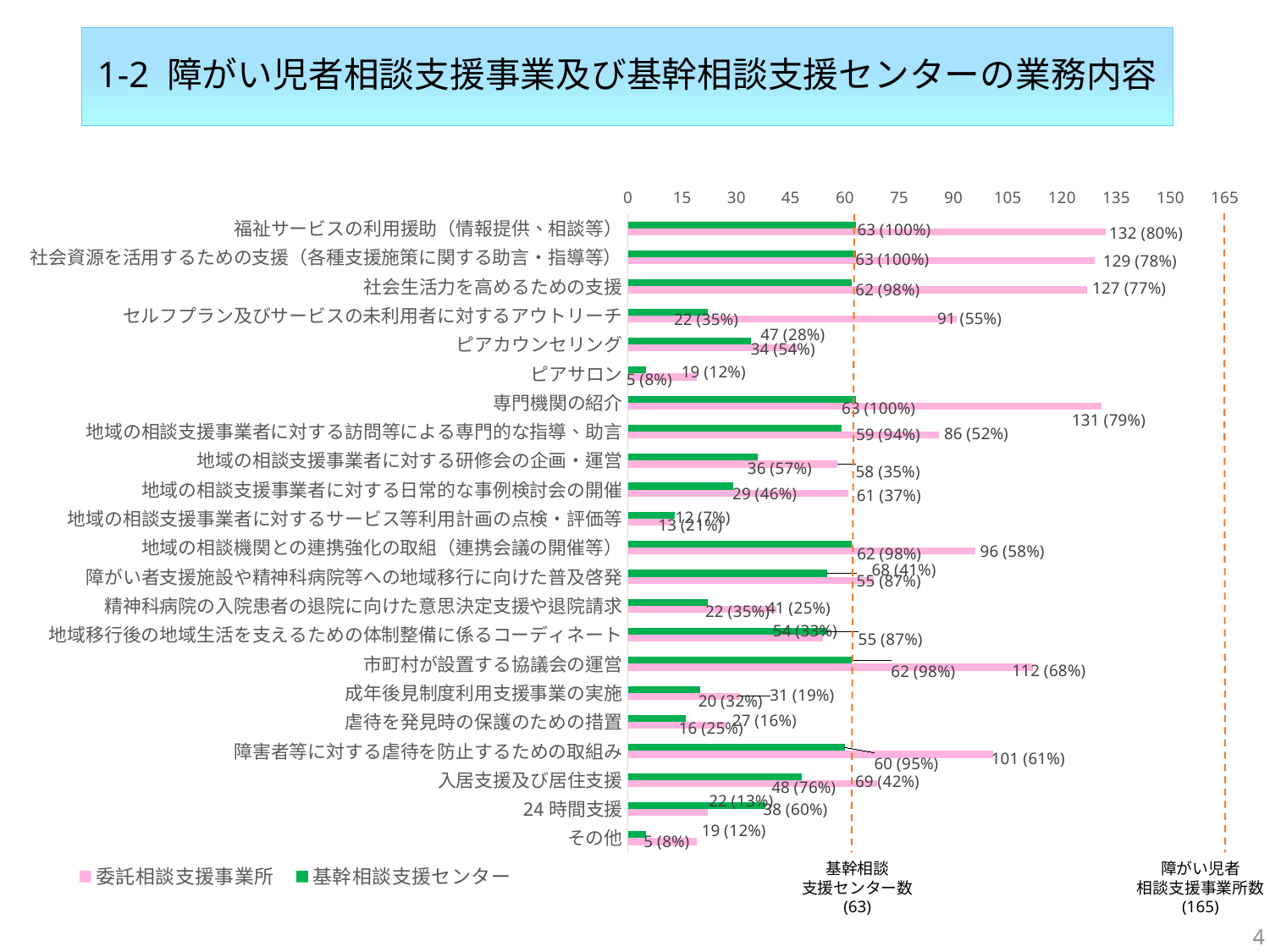
For 24 時間支援, which series has the larger count, 委託相談支援事業所 or 基幹相談支援センター? 基幹相談支援センター Which category has the highest value for 委託相談支援事業所? 福祉サービスの利用援助（情報提供、相談等） For ピアカウンセリング, which series has the larger count, 委託相談支援事業所 or 基幹相談支援センター? 委託相談支援事業所 What is the value for 委託相談支援事業所 in the category 福祉サービスの利用援助（情報提供、相談等）? 132 (80%) What is the value for 委託相談支援事業所 in the category 障害者等に対する虐待を防止するための取組み? 101 (61%) Is the 委託相談支援事業所 value for セルフプラン及びサービスの未利用者に対するアウトリーチ greater or less than 75? greater Which category has the lowest value for 委託相談支援事業所? 地域の相談支援事業者に対するサービス等利用計画の点検・評価等 How many categories are shown on the chart? 22 How many series does the legend list? 2 What is the value for 基幹相談支援センター in the category 市町村が設置する協議会の運営? 62 (98%) What is the difference between the 委託相談支援事業所 count and the 基幹相談支援センター count for 専門機関の紹介? 68 What kind of chart is shown on the slide? Bar chart